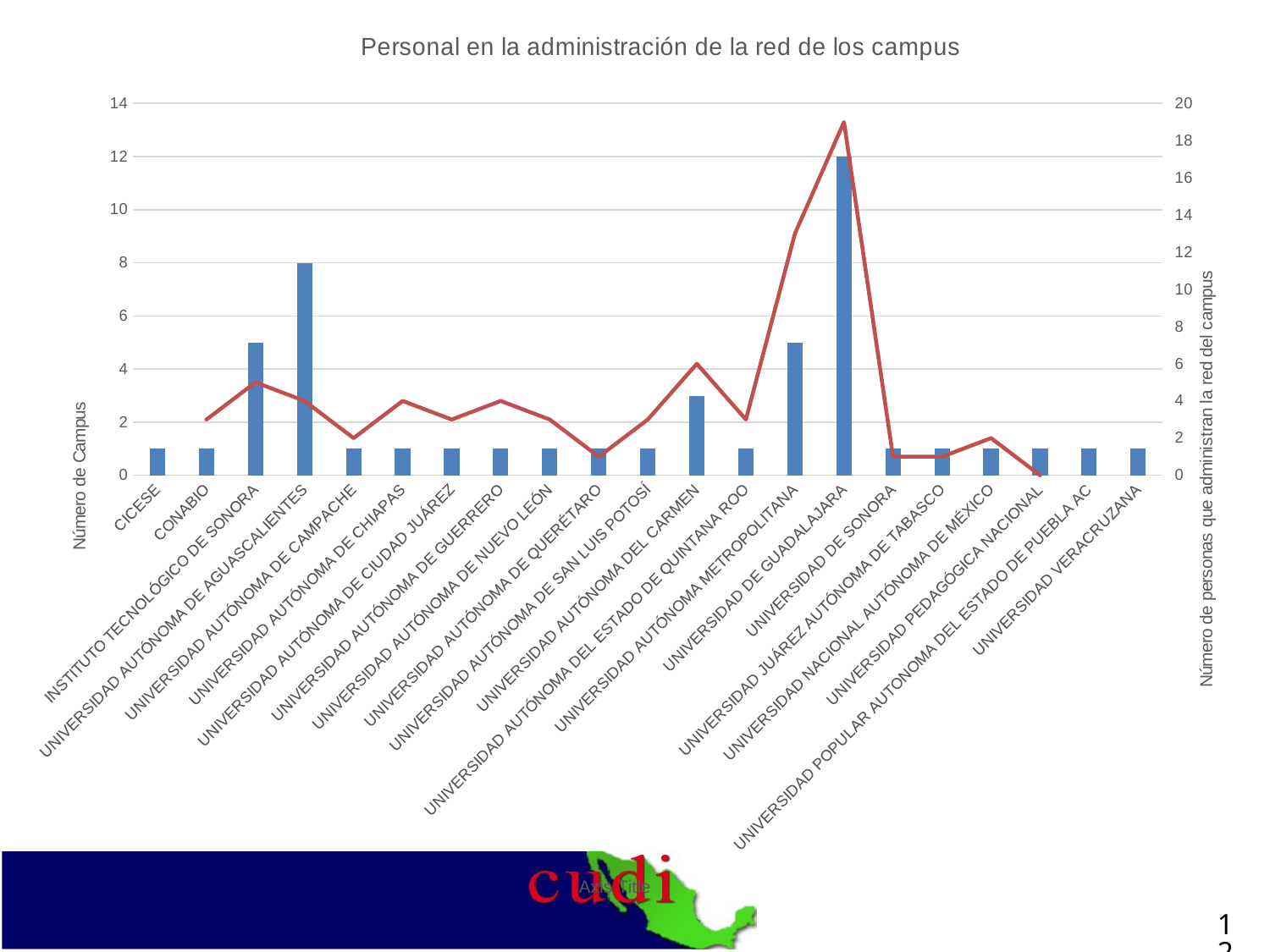
What kind of chart is shown on the slide? A combination bar and line chart What is the Número de Campus value for UNIVERSIDAD AUTÓNOMA DE AGUASCALIENTES? 8 How many institutions are listed on the x axis of the chart? 21 Which has a higher Número de Campus bar: UNIVERSIDAD AUTÓNOMA DE AGUASCALIENTES or UNIVERSIDAD AUTÓNOMA DEL CARMEN? UNIVERSIDAD AUTÓNOMA DE AGUASCALIENTES Which institution has the highest bar (Número de Campus)? UNIVERSIDAD DE GUADALAJARA What is the difference in Número de Campus between UNIVERSIDAD DE GUADALAJARA and UNIVERSIDAD AUTÓNOMA DE AGUASCALIENTES? 4 What is the title of the left vertical axis? Número de Campus What is the Número de Campus value for UNIVERSIDAD DE GUADALAJARA? 12 What is the title of the chart? Personal en la administración de la red de los campus Is the line value (Número de personas que administran la red del campus) for UNIVERSIDAD DE GUADALAJARA greater or less than 16? greater